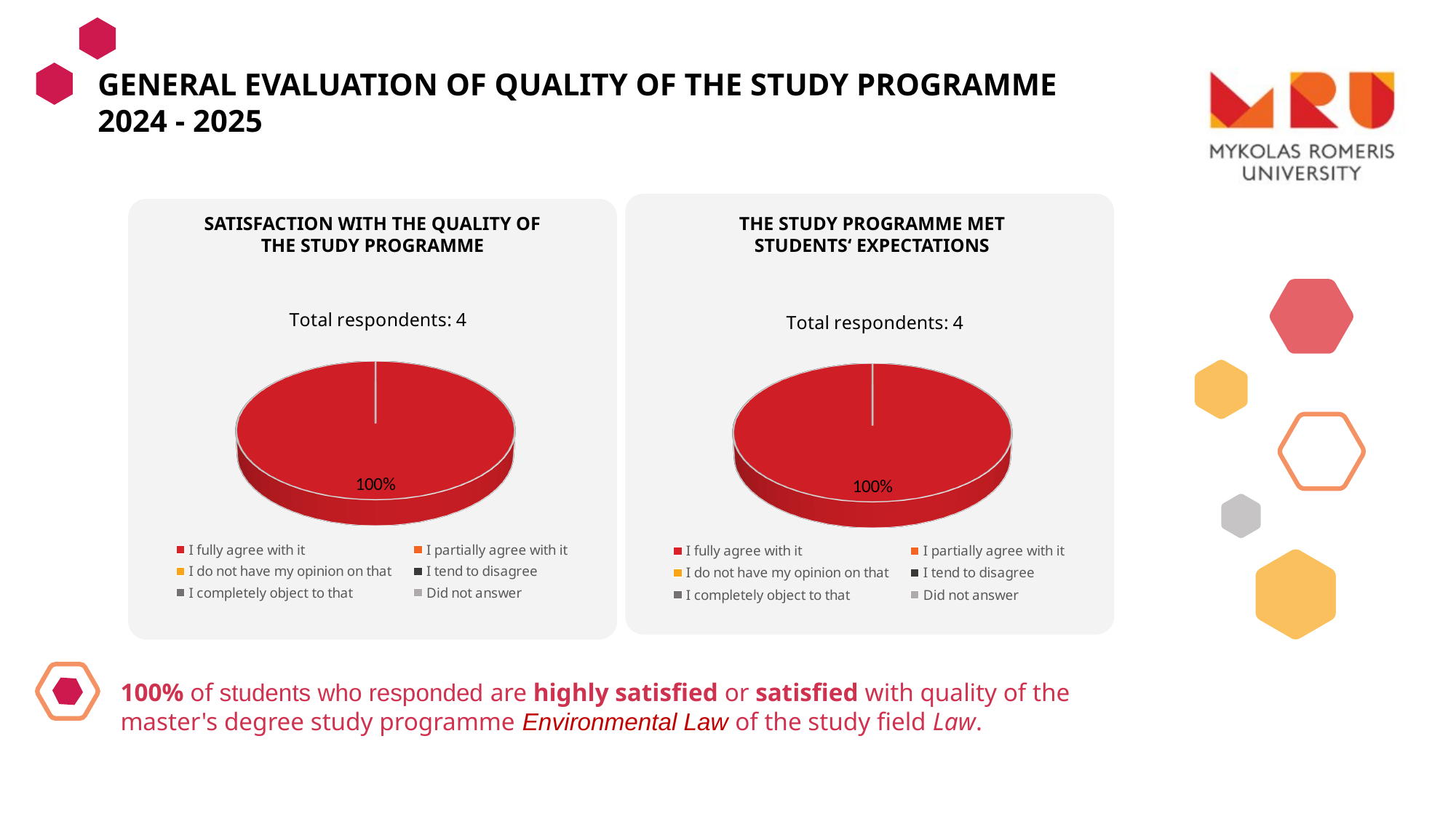
In the 'The study programme met students' expectations' chart, which category has the largest share? I fully agree with it In the 'The study programme met students' expectations' chart, how many entries does the legend list? 6 In the 'The study programme met students' expectations' chart, what share of the pie is 'I fully agree with it'? 100% In the 'Satisfaction with the quality of the study programme' chart, which category has the largest share? I fully agree with it In the 'Satisfaction with the quality of the study programme' chart, what share of the pie is 'I fully agree with it'? 100% What kind of chart is the 'Satisfaction with the quality of the study programme' chart? Pie chart In the 'The study programme met students' expectations' chart, what colour is the 'I fully agree with it' slice? Red What kind of chart is the 'The study programme met students' expectations' chart? Pie chart How many total respondents are reported for the 'Satisfaction with the quality of the study programme' chart? 4 In the 'Satisfaction with the quality of the study programme' chart, how many slices are visible in the pie? 1 In the 'Satisfaction with the quality of the study programme' chart, how many entries does the legend list? 6